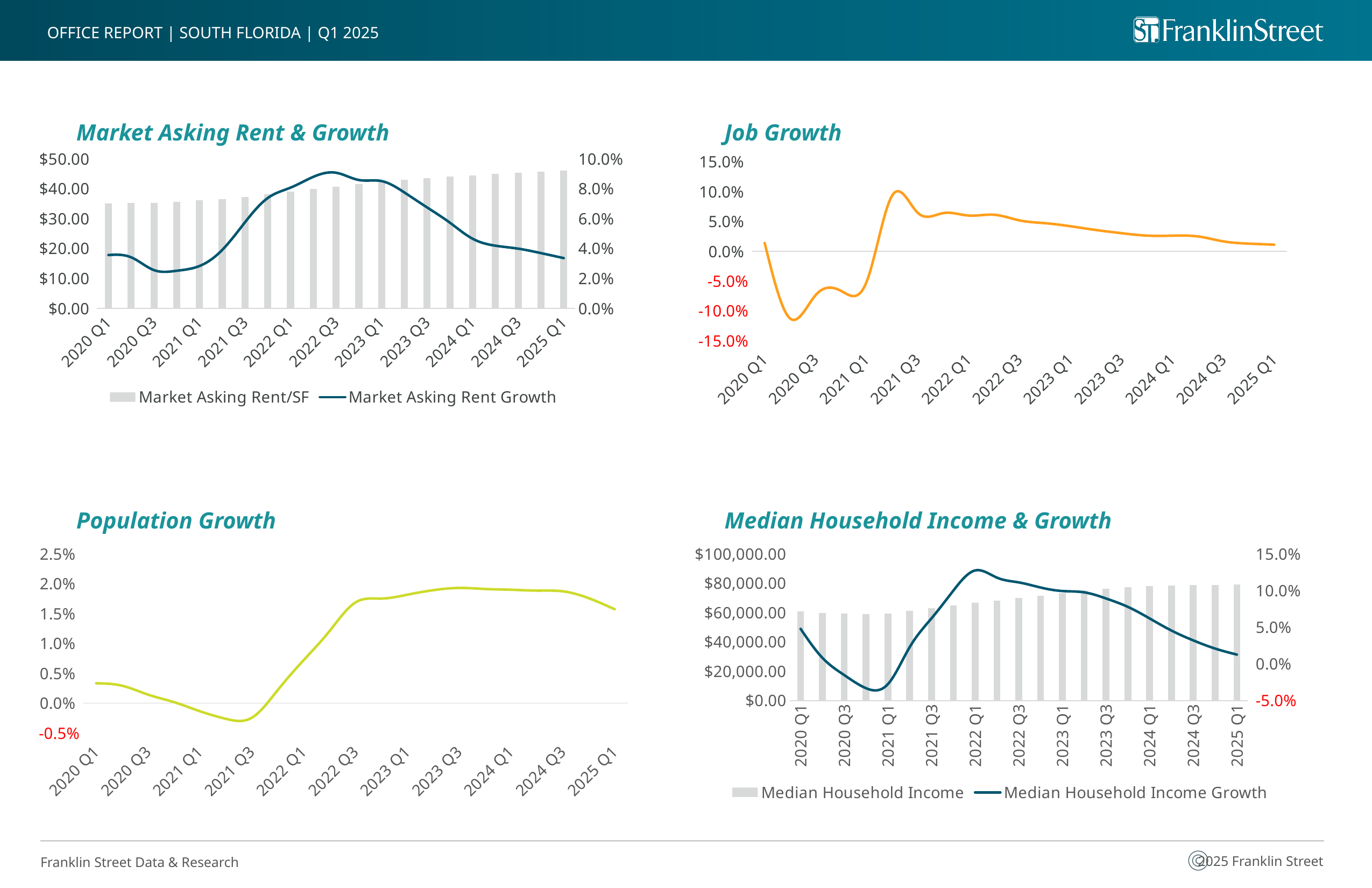
In the Market Asking Rent & Growth chart, is the Market Asking Rent/SF bar for 2025 Q1 greater or less than $40.00? greater In the Market Asking Rent & Growth chart, do the Market Asking Rent/SF bars generally rise or fall from 2020 Q1 to 2025 Q1? rise In the Median Household Income & Growth chart, is the Median Household Income bar for 2025 Q1 greater or less than $60,000.00? greater In the Market Asking Rent & Growth chart, in which quarter does the Market Asking Rent Growth line reach its highest point? 2022 Q3 In the Job Growth chart, is the value for 2025 Q1 greater or less than 5.0%? less In the Job Growth chart, in which quarter is job growth at its lowest? 2020 Q2 In the Median Household Income & Growth chart, in which quarter does the Median Household Income Growth line peak? 2022 Q1 What kind of chart is the Population Growth chart? line chart In the Market Asking Rent & Growth chart, how many series does the legend list? 2 In the Job Growth chart, which is larger: the value for 2021 Q2 or the value for 2024 Q1? 2021 Q2